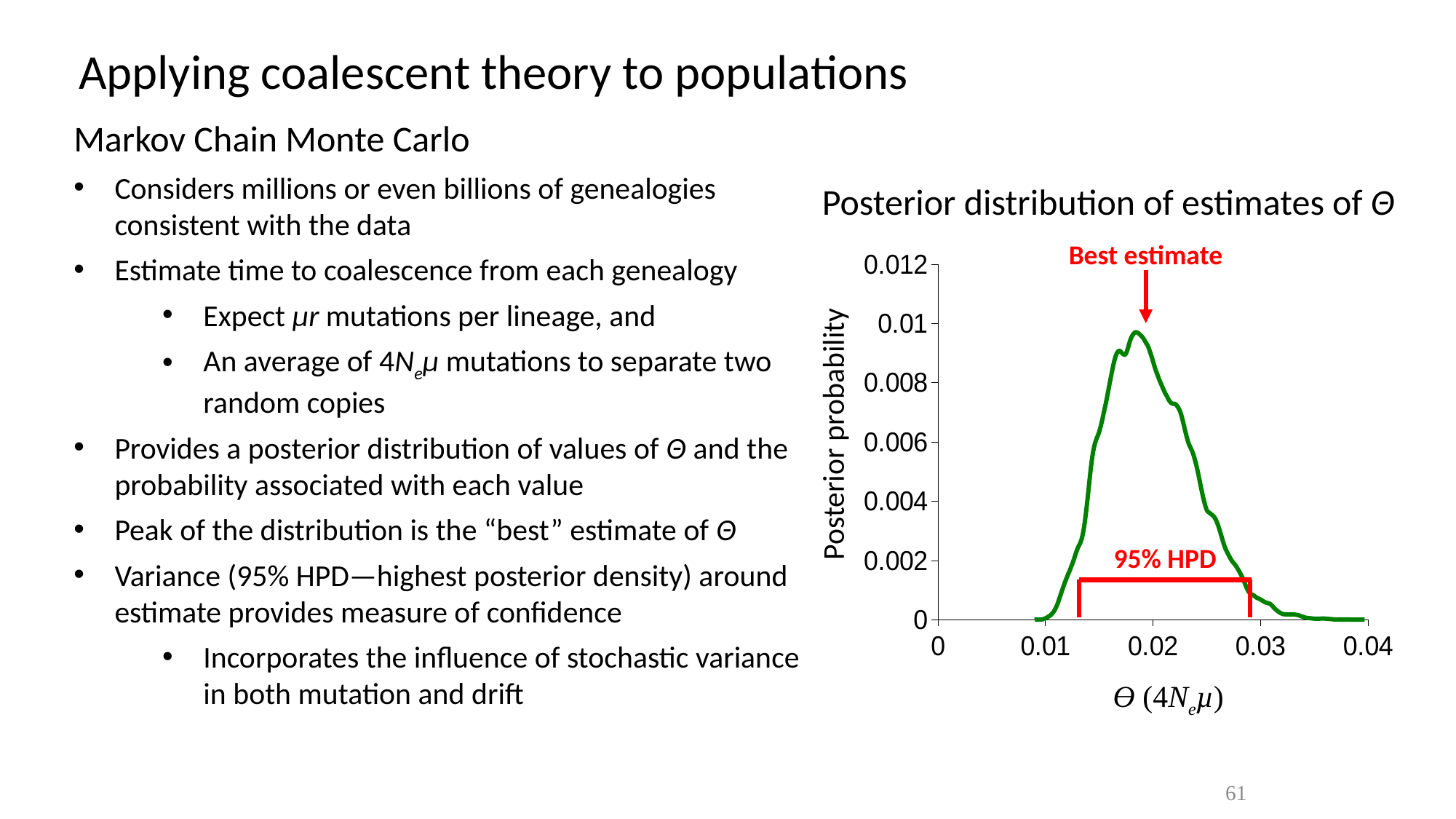
What is the title of the chart? Posterior distribution of estimates of Θ Is the posterior probability at Θ = 0.02 greater or less than 0.006? greater Which is larger, the posterior probability at Θ = 0.02 or at Θ = 0.03? Θ = 0.02 Is the posterior probability at Θ = 0.01 greater or less than 0.002? less How does the posterior probability change as Θ increases from 0.01 to 0.02? It rises Is the peak posterior probability of the curve greater or less than 0.008? greater What is the label of the y axis of the chart? Posterior probability What kind of chart is shown on the slide? Line chart What is the highest tick value shown on the y axis of the chart? 0.012 How does the posterior probability change as Θ increases from 0.02 to 0.03? It falls